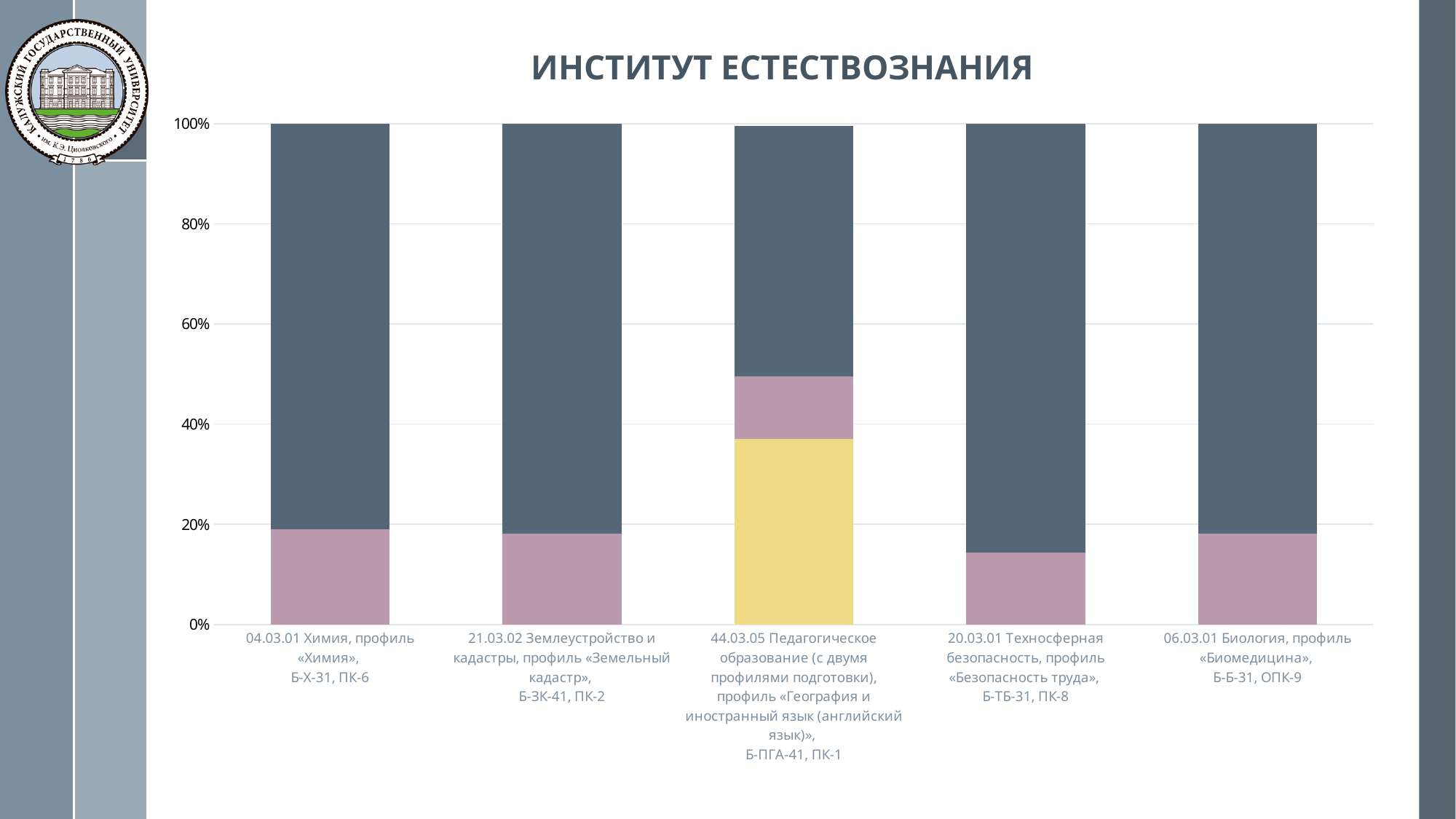
Is the pink (bottom) segment for 21.03.02 Землеустройство и кадастры, Б-ЗК-41, ПК-2 greater or less than 20%? less Is the yellow segment for 44.03.05 Педагогическое образование, Б-ПГА-41, ПК-1 greater or less than 20%? greater How many categories (programmes) are shown on the x axis of the chart? 5 What is the title of the chart on the slide? ИНСТИТУТ ЕСТЕСТВОЗНАНИЯ Which category has the smallest dark grey (top) segment? 44.03.05 Педагогическое образование (с двумя профилями подготовки), профиль «География и иностранный язык (английский язык)», Б-ПГА-41, ПК-1 What kind of chart is shown on the slide? stacked bar chart Which category is the only one with a yellow segment in its bar? 44.03.05 Педагогическое образование (с двумя профилями подготовки), профиль «География и иностранный язык (английский язык)», Б-ПГА-41, ПК-1 Is the yellow segment for 44.03.05 Педагогическое образование, Б-ПГА-41, ПК-1 greater or less than 40%? less